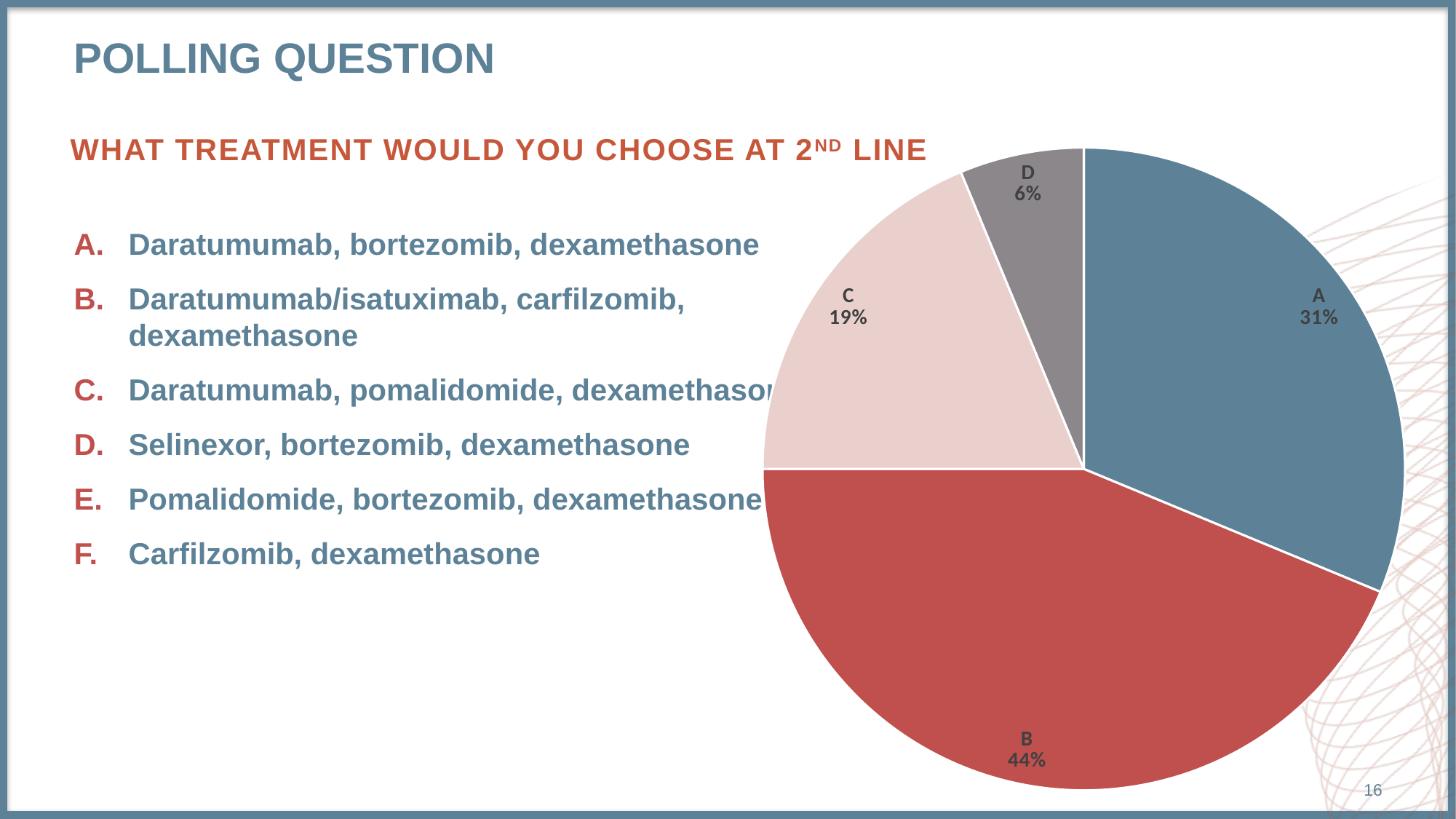
Which is larger, the slice for option A or the slice for option C? A Which option has the largest slice of the pie? B Which option has the smallest slice of the pie? D What share of the pie does option D have? 6% What is the difference in percentage points between option C and option D? 13 What is the difference in percentage points between option B and option A? 13 How many slices does the pie chart have? 4 What colour is the slice for option B? red What share of the pie does option B have? 44% What share of the pie does option C have? 19% What kind of chart is shown on the slide? pie chart